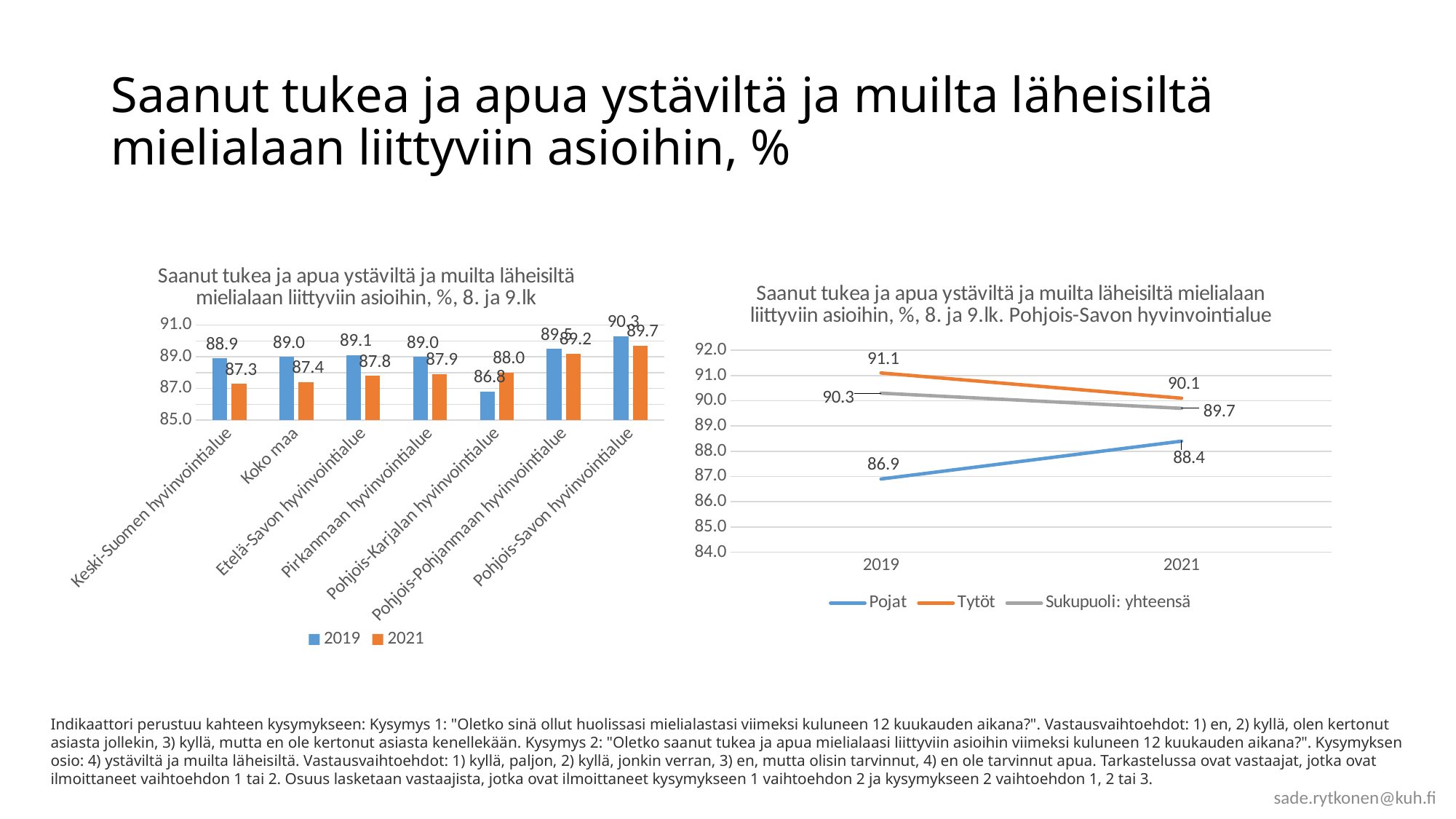
In the right line chart, what is the difference between the Tytöt and Pojat values in 2019? 4.2 In the left bar chart, what is the 2019 value for Koko maa? 89.0 How many series does the legend of the left bar chart list? 2 In the left bar chart, what is the 2021 value for Pohjois-Karjalan hyvinvointialue? 88.0 In the left bar chart, for Pohjois-Karjalan hyvinvointialue, which is larger: the 2019 value or the 2021 value? 2021 In the right line chart, does the Pojat line rise or fall from 2019 to 2021? Rises What kind of chart is the chart on the right side of the slide? Line chart In the right line chart, what is the value for Tytöt in 2021? 90.1 In the left bar chart, what is the difference between the 2019 and 2021 values for Keski-Suomen hyvinvointialue? 1.6 In the left bar chart, which category has the highest 2019 value? Pohjois-Savon hyvinvointialue How many categories are shown on the x axis of the left bar chart? 7 In the left bar chart, which category has the lowest 2021 value? Keski-Suomen hyvinvointialue